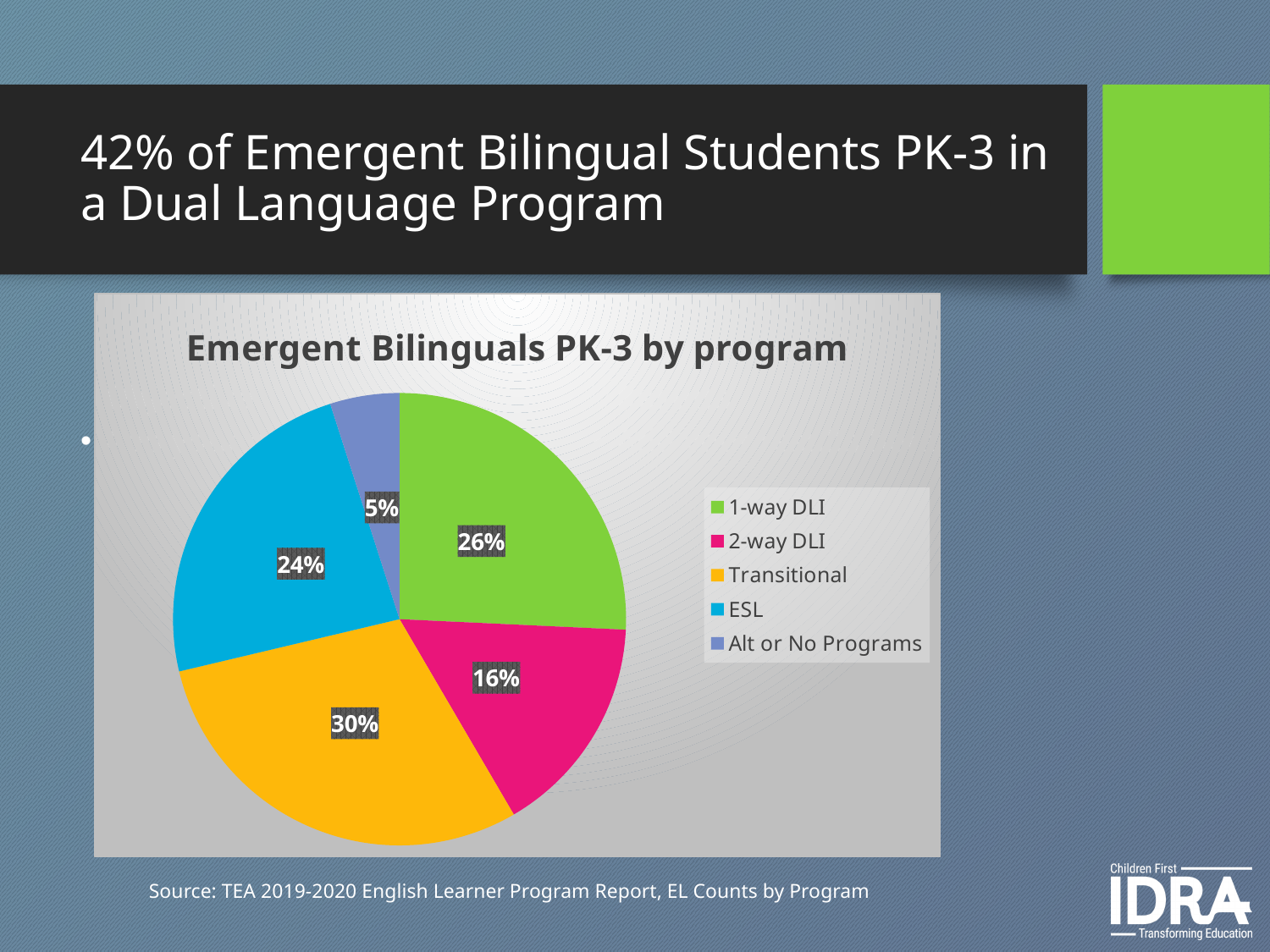
What is the difference in percentage points between the 1-way DLI and 2-way DLI shares? 10 Which program has the largest share of Emergent Bilinguals PK-3? Transitional What is the chart's title? Emergent Bilinguals PK-3 by program What kind of chart is shown on the slide? pie chart Which program has the smallest share of Emergent Bilinguals PK-3? Alt or No Programs How many program categories does the pie chart show? 5 What colour is the 2-way DLI slice? magenta/pink Which has a larger share, ESL or 2-way DLI? ESL What share of Emergent Bilinguals PK-3 are in a 1-way DLI program? 26% What share of Emergent Bilinguals PK-3 are in Alt or No Programs? 5% What share of Emergent Bilinguals PK-3 are in ESL? 24% What share of Emergent Bilinguals PK-3 are in a Transitional program? 30%